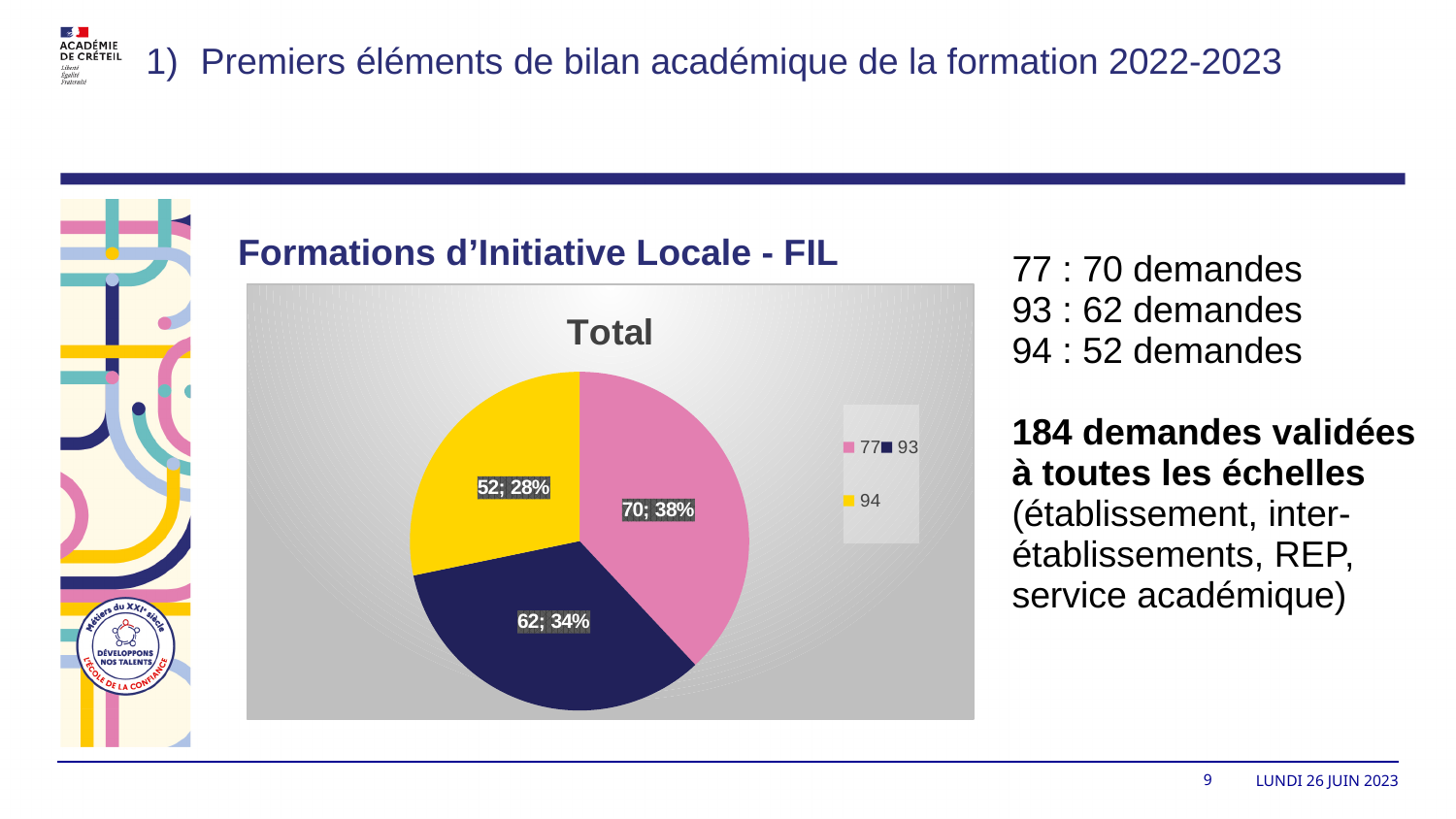
What share of the pie does the slice labelled 94 represent? 28% What value is shown for the slice labelled 93? 62 How many slices does the pie chart have? 3 Which slice is the smallest in the pie chart? 94 What share of the pie does the slice labelled 77 represent? 38% What value is shown for the slice labelled 94? 52 How many entries does the chart legend list? 3 What is the title of the chart? Total What value is shown for the slice labelled 77? 70 What kind of chart is shown on the slide? pie chart Which slice is the largest in the pie chart? 77 What is the difference between the values for slices 77 and 94? 18